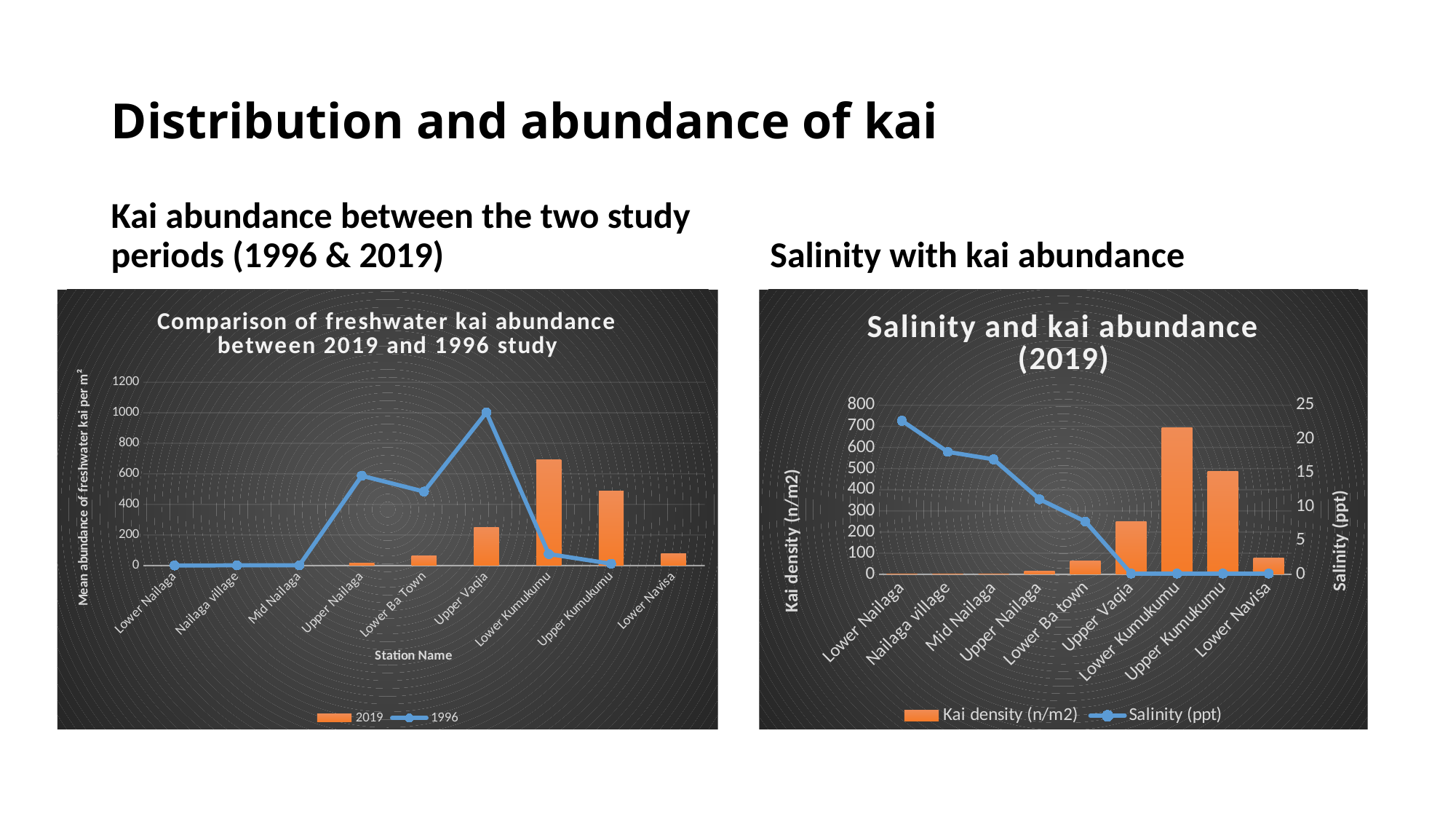
In the left chart 'Comparison of freshwater kai abundance between 2019 and 1996 study', which station has the highest 2019 abundance? Lower Kumukumu In the left chart 'Comparison of freshwater kai abundance between 2019 and 1996 study', is the 1996 value for Upper Nailaga greater or less than 400? greater In the left chart 'Comparison of freshwater kai abundance between 2019 and 1996 study', what is the x-axis title? Station Name In the left chart 'Comparison of freshwater kai abundance between 2019 and 1996 study', is the 2019 value for Lower Kumukumu greater or less than 600? greater In the left chart 'Comparison of freshwater kai abundance between 2019 and 1996 study', how many series does the legend list? 2 In the left chart 'Comparison of freshwater kai abundance between 2019 and 1996 study', how many stations are shown on the x axis? 9 In the left chart titled 'Comparison of freshwater kai abundance between 2019 and 1996 study', what kind of chart is it? A combined bar and line chart In the right chart 'Salinity and kai abundance (2019)', is the salinity at Lower Nailaga greater or less than 20? greater In the left chart 'Comparison of freshwater kai abundance between 2019 and 1996 study', which station has the highest 1996 abundance? Upper Vaqia In the right chart 'Salinity and kai abundance (2019)', which station has the highest kai density? Lower Kumukumu In the right chart 'Salinity and kai abundance (2019)', what are the two legend entries? Kai density (n/m2) and Salinity (ppt) In the right chart 'Salinity and kai abundance (2019)', does salinity rise or fall from Lower Nailaga to Lower Navisa? fall